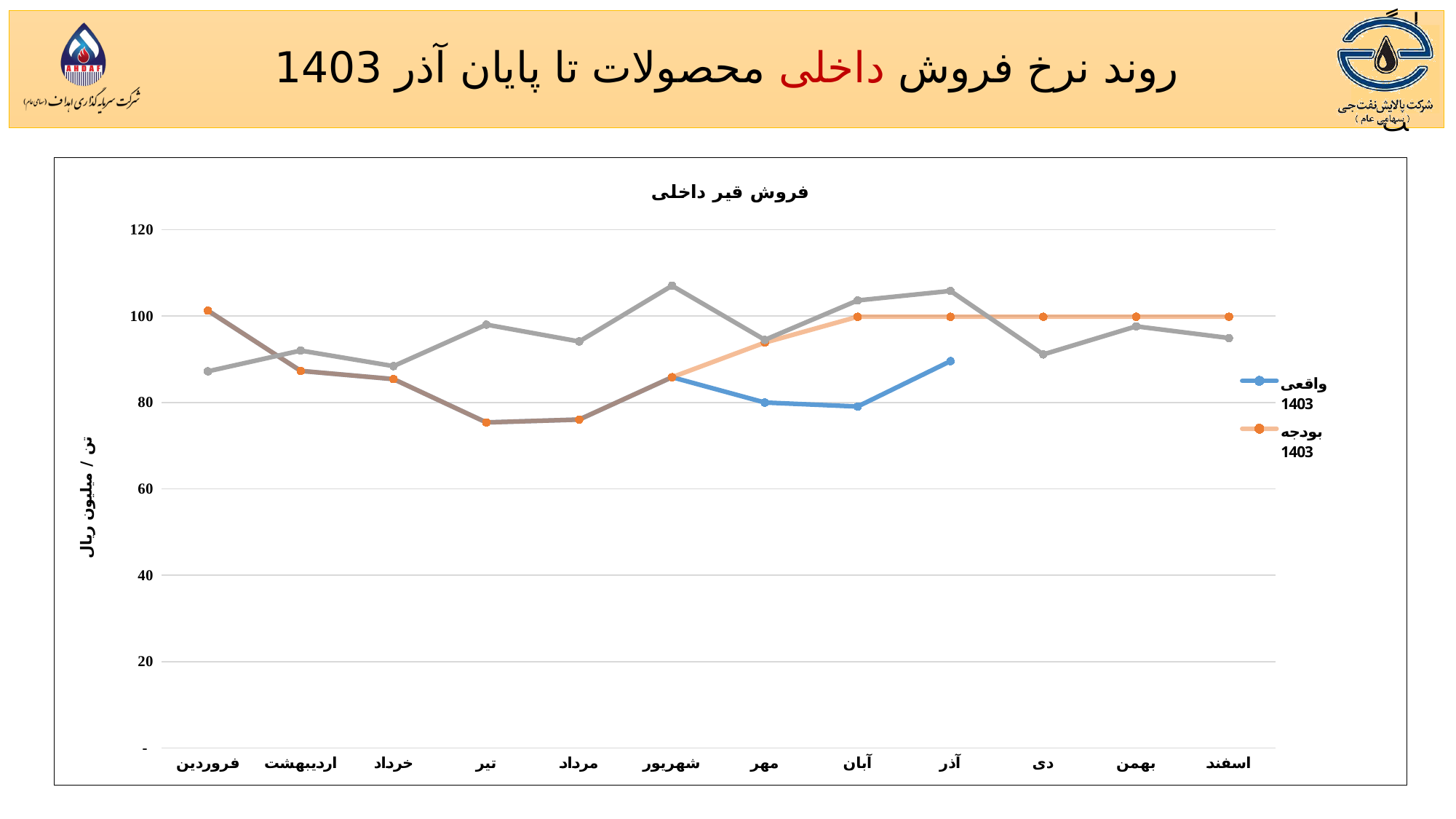
What is the label on the vertical axis? تن / میلیون ریال What is the title of the chart? فروش قیر داخلی For آبان, which is larger: واقعی 1403 or بودجه 1403? بودجه 1403 What kind of chart is shown on the slide? line chart Is the value of واقعی 1403 for آذر greater or less than 80? greater Is the value of بودجه 1403 for دی greater or less than 80? greater Is the value of واقعی 1403 for آبان greater or less than 100? less For بودجه 1403, which is larger: the value for فروردین or the value for تیر? فروردین Does the بودجه 1403 line rise, fall or stay flat from آبان to اسفند? stays flat How many months are shown on the x axis? 12 How many series does the legend list? 2